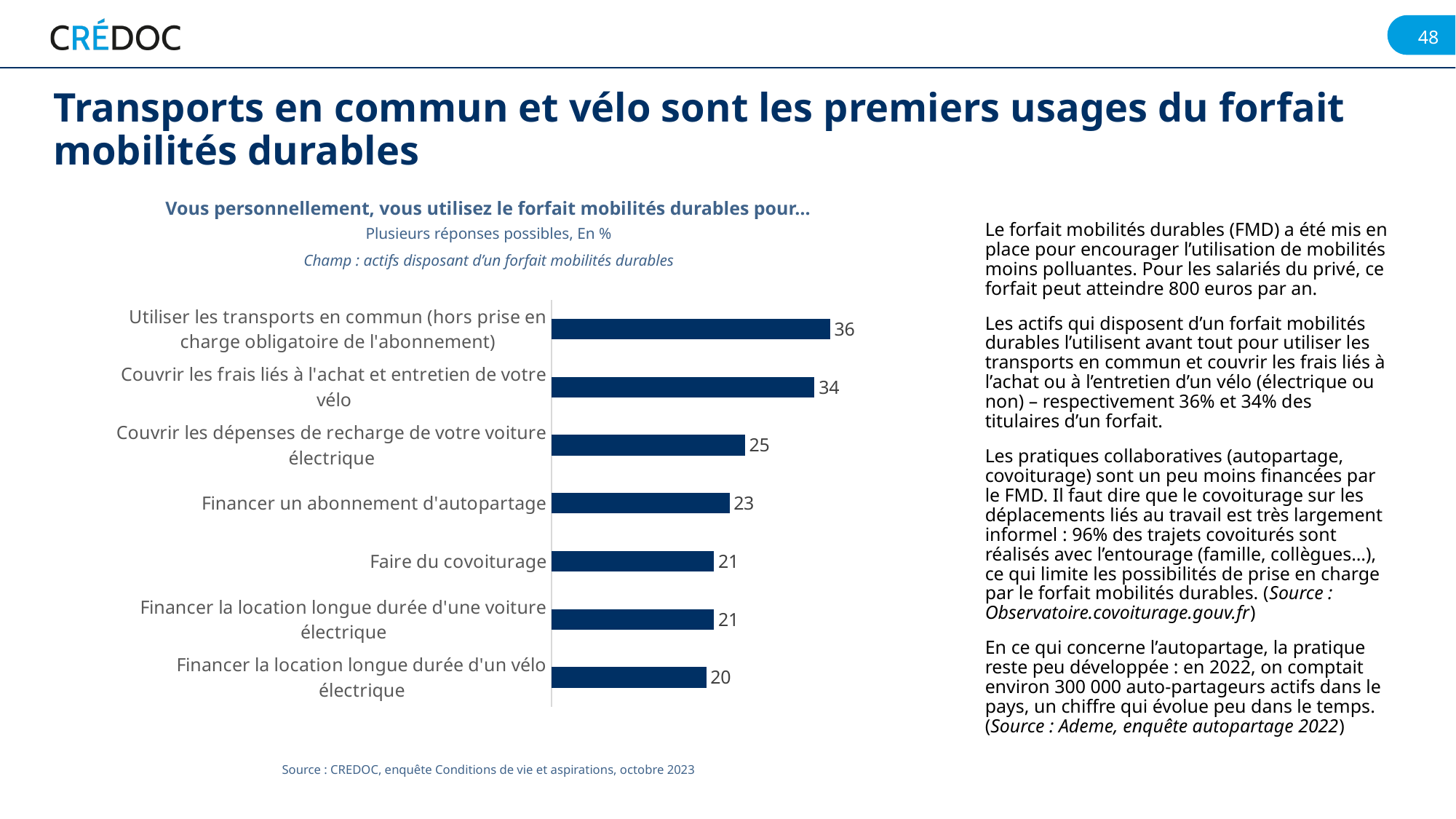
What is the difference between the values for "Couvrir les frais liés à l'achat et entretien de votre vélo" and "Faire du covoiturage"? 13 What is the value for "Couvrir les dépenses de recharge de votre voiture électrique"? 25 How many categories are shown in the chart? 7 Which is larger: the value for "Couvrir les dépenses de recharge de votre voiture électrique" or for "Financer un abonnement d'autopartage"? Couvrir les dépenses de recharge de votre voiture électrique Which category has the highest value? Utiliser les transports en commun (hors prise en charge obligatoire de l'abonnement) Which category has the lowest value? Financer la location longue durée d'un vélo électrique What kind of chart is shown on the slide? Bar chart What is the difference between the values for "Utiliser les transports en commun" and "Couvrir les frais liés à l'achat et entretien de votre vélo"? 2 What is the value for "Utiliser les transports en commun (hors prise en charge obligatoire de l'abonnement)"? 36 What is the title of the chart? Vous personnellement, vous utilisez le forfait mobilités durables pour… What is the value for "Financer la location longue durée d'un vélo électrique"? 20 What is the value for "Financer un abonnement d'autopartage"? 23